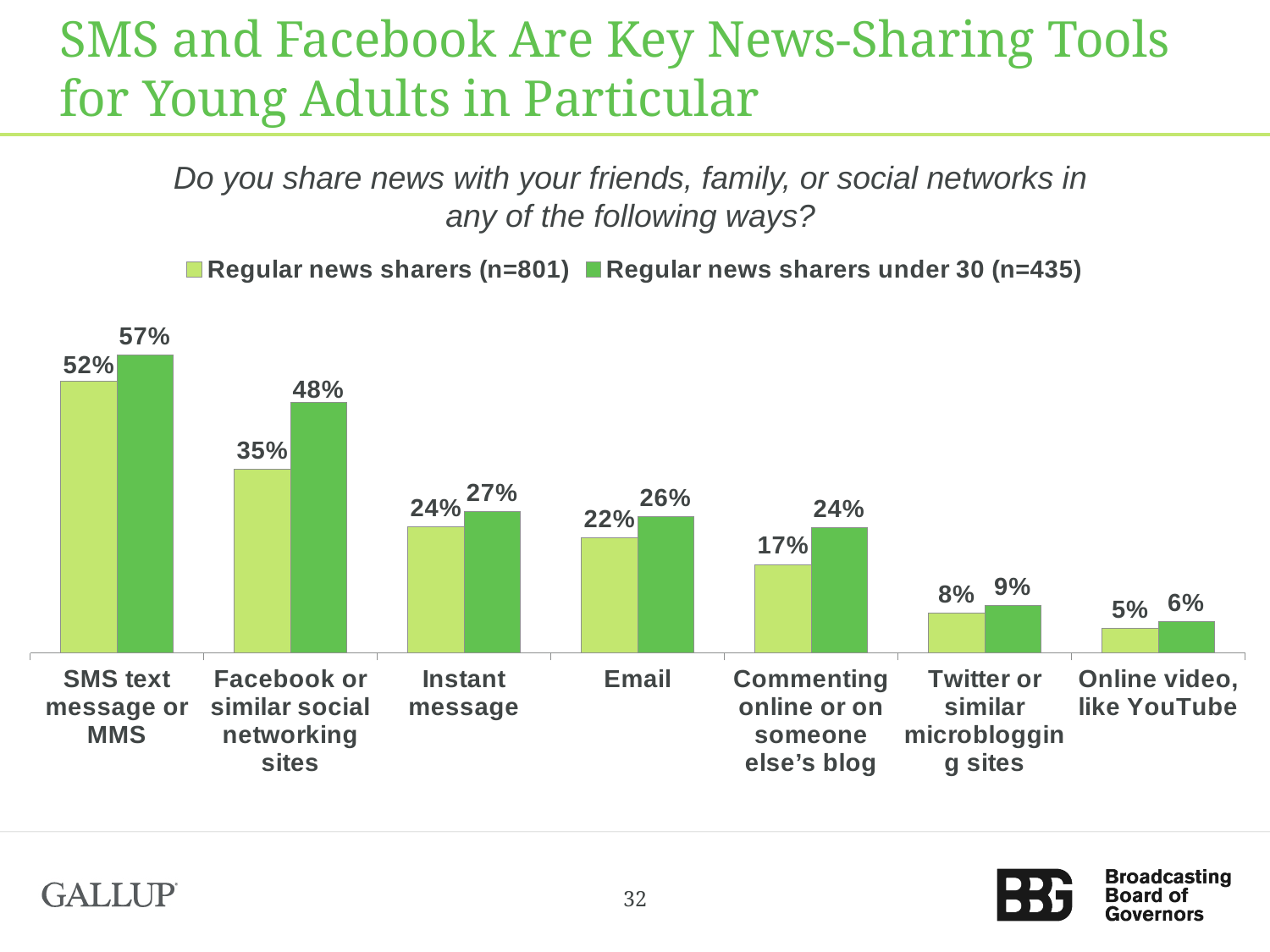
Which is larger: the value for Instant message among regular news sharers (n=801) or the value for Email among regular news sharers under 30 (n=435)? Email among regular news sharers under 30 (n=435) What percentage of regular news sharers under 30 (n=435) share news via Facebook or similar social networking sites? 48% What kind of chart is shown on the slide? Bar chart What is the difference between the two series for Commenting online or on someone else's blog? 7% What is the difference between regular news sharers under 30 and all regular news sharers for Facebook or similar social networking sites? 13% How many series does the legend list? 2 Which category has the highest value for regular news sharers under 30 (n=435)? SMS text message or MMS What is the value for Email among regular news sharers under 30 (n=435)? 26% Do the values for regular news sharers (n=801) rise or fall moving from left to right along the x axis? Fall What percentage of regular news sharers (n=801) share news by SMS text message or MMS? 52% How many categories are shown on the x axis of the chart? 7 Which category has the lowest value for regular news sharers (n=801)? Online video, like YouTube